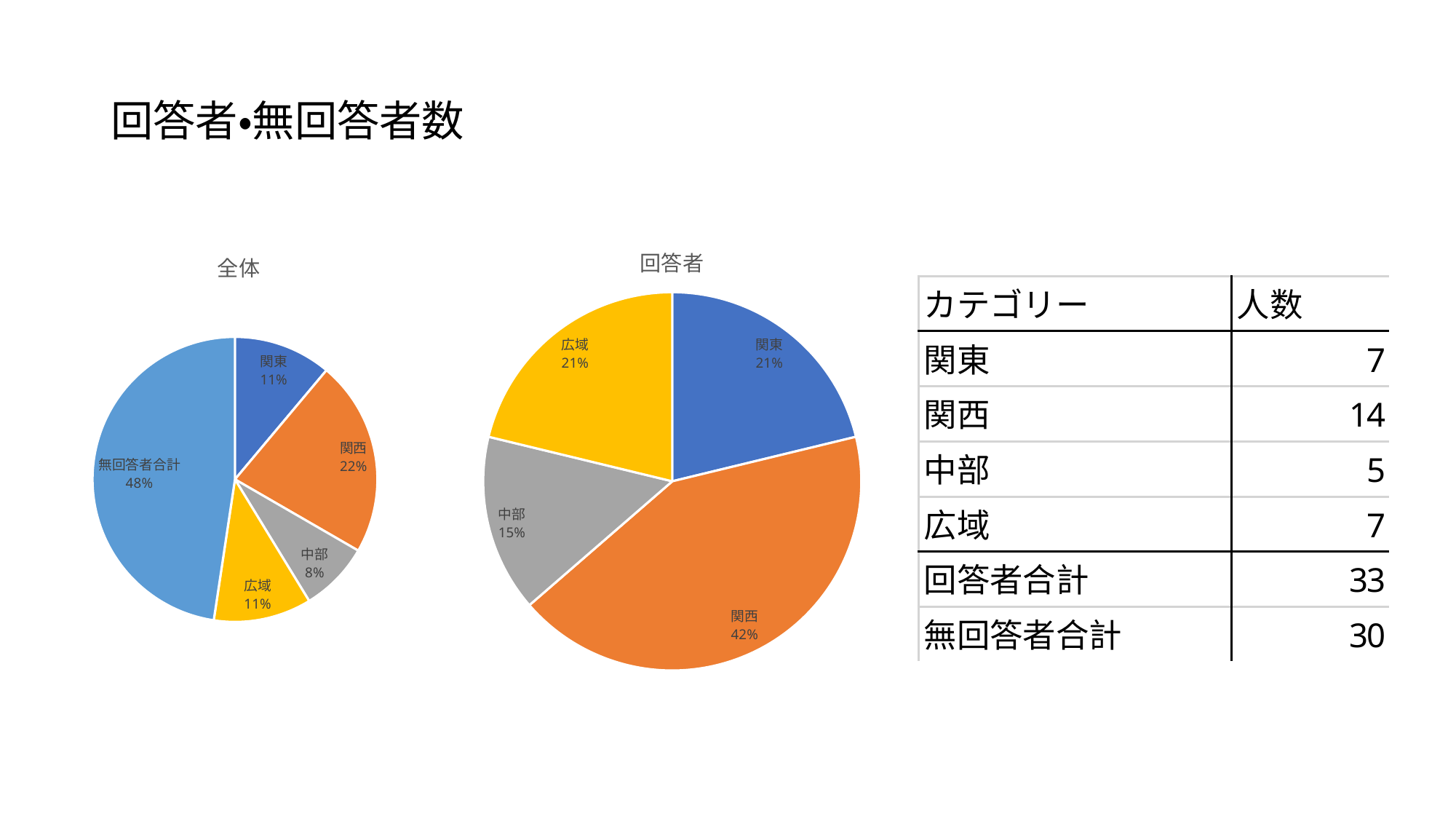
In the 全体 pie chart, which slice is the smallest? 中部 How many slices does the 全体 pie chart have? 5 In the 回答者 pie chart, what share does 中部 have? 15% In the 回答者 pie chart, which slice is the smallest? 中部 In the 全体 pie chart, which slice is the largest? 無回答者合計 In the 回答者 pie chart, what is the difference in percentage points between 関西 and 関東? 21 percentage points In the 回答者 pie chart, what share does 関西 have? 42% In the 全体 pie chart, what share does 無回答者合計 have? 48% How many slices does the 回答者 pie chart have? 4 In the 回答者 pie chart, which slice is the largest? 関西 What type of chart is the 回答者 chart? pie chart